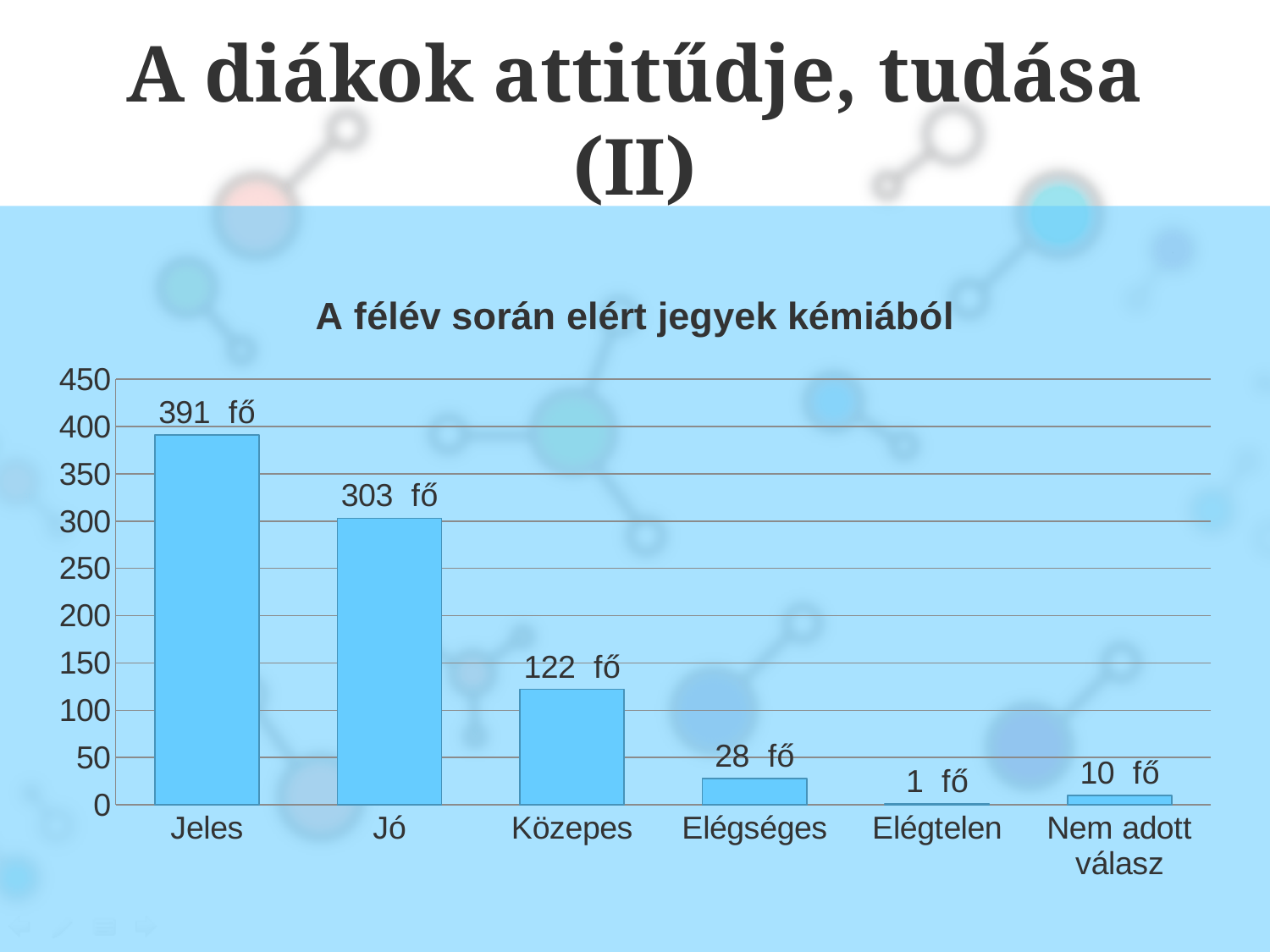
What is the value for Nem adott válasz? 10 fő Which category has the lowest value? Elégtelen What kind of chart is shown on the slide? bar chart Which is larger, the value for Elégséges or the value for Nem adott válasz? Elégséges What is the value for Közepes? 122 fő What is the title of the chart? A félév során elért jegyek kémiából Which category has the highest value? Jeles What is the difference between the values for Közepes and Elégséges? 94 fő How many categories are shown on the x axis? 6 Is the value for Jó greater or less than 350? less What is the value for Jeles? 391 fő What is the difference between the values for Jeles and Jó? 88 fő